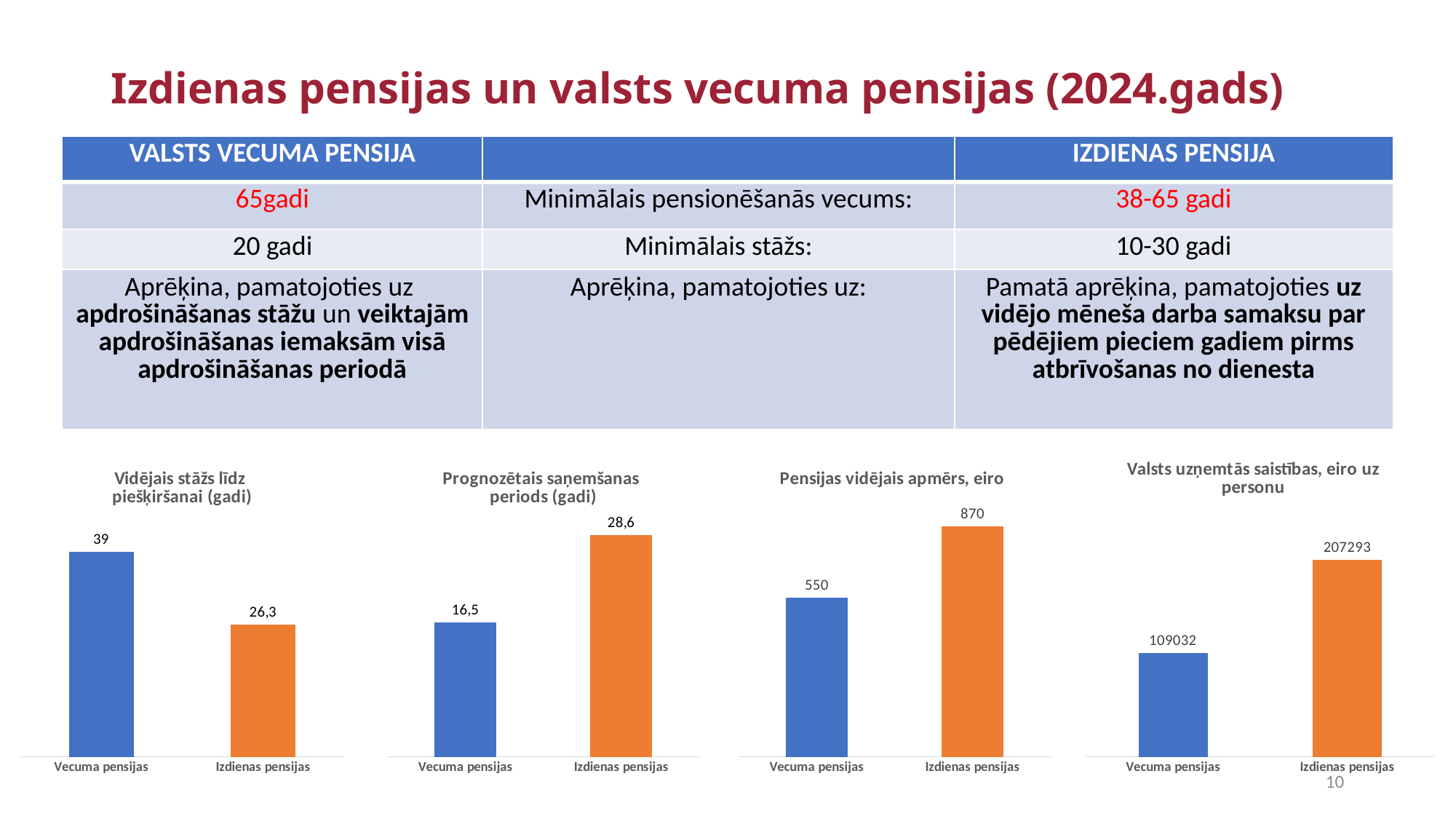
In the chart titled "Prognozētais saņemšanas periods (gadi)", which category has the lowest value? Vecuma pensijas In the chart titled "Pensijas vidējais apmērs, eiro", what is the value for Vecuma pensijas? 550 In the chart titled "Prognozētais saņemšanas periods (gadi)", what is the value for Izdienas pensijas? 28,6 In the chart titled "Vidējais stāžs līdz piešķiršanai (gadi)", what is the value for Vecuma pensijas? 39 In the chart titled "Vidējais stāžs līdz piešķiršanai (gadi)", which is larger, Vecuma pensijas or Izdienas pensijas? Vecuma pensijas In the chart titled "Valsts uzņemtās saistības, eiro uz personu", which category has the highest value? Izdienas pensijas What kind of chart is the chart titled "Valsts uzņemtās saistības, eiro uz personu"? bar chart In the chart titled "Prognozētais saņemšanas periods (gadi)", what is the difference between Izdienas pensijas and Vecuma pensijas? 12,1 In the chart titled "Pensijas vidējais apmērs, eiro", what is the difference between Izdienas pensijas and Vecuma pensijas? 320 How many categories are shown in the chart titled "Pensijas vidējais apmērs, eiro"? 2 In the chart titled "Valsts uzņemtās saistības, eiro uz personu", what is the value for Izdienas pensijas? 207293 In the chart titled "Vidējais stāžs līdz piešķiršanai (gadi)", what is the value for Izdienas pensijas? 26,3